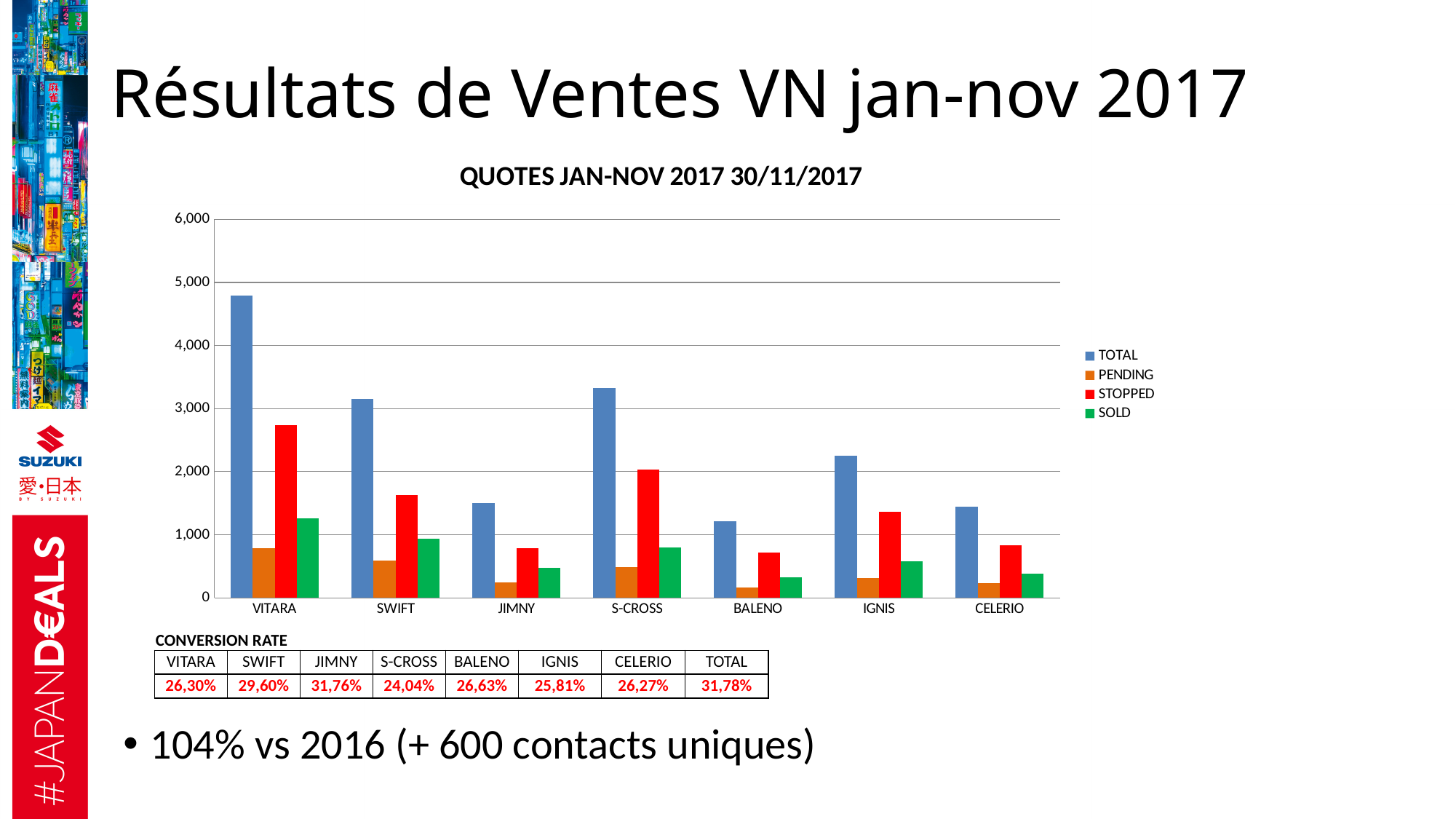
What colour represents the STOPPED series in the chart legend? red Which model has the highest SOLD bar in the QUOTES JAN-NOV 2017 chart? VITARA Is the STOPPED value for IGNIS greater or less than 1,000? greater Is the STOPPED value for VITARA greater or less than 3,000? less Which model has the lowest TOTAL bar in the QUOTES JAN-NOV 2017 chart? BALENO How many car models are shown on the x axis of the QUOTES JAN-NOV 2017 chart? 7 How many series does the legend of the QUOTES JAN-NOV 2017 chart list? 4 Which model has the highest TOTAL bar in the QUOTES JAN-NOV 2017 chart? VITARA Is the TOTAL value for VITARA greater or less than 4,000? greater Which is larger, the TOTAL value for IGNIS or the TOTAL value for CELERIO? IGNIS What kind of chart is shown under the title QUOTES JAN-NOV 2017 30/11/2017? bar chart